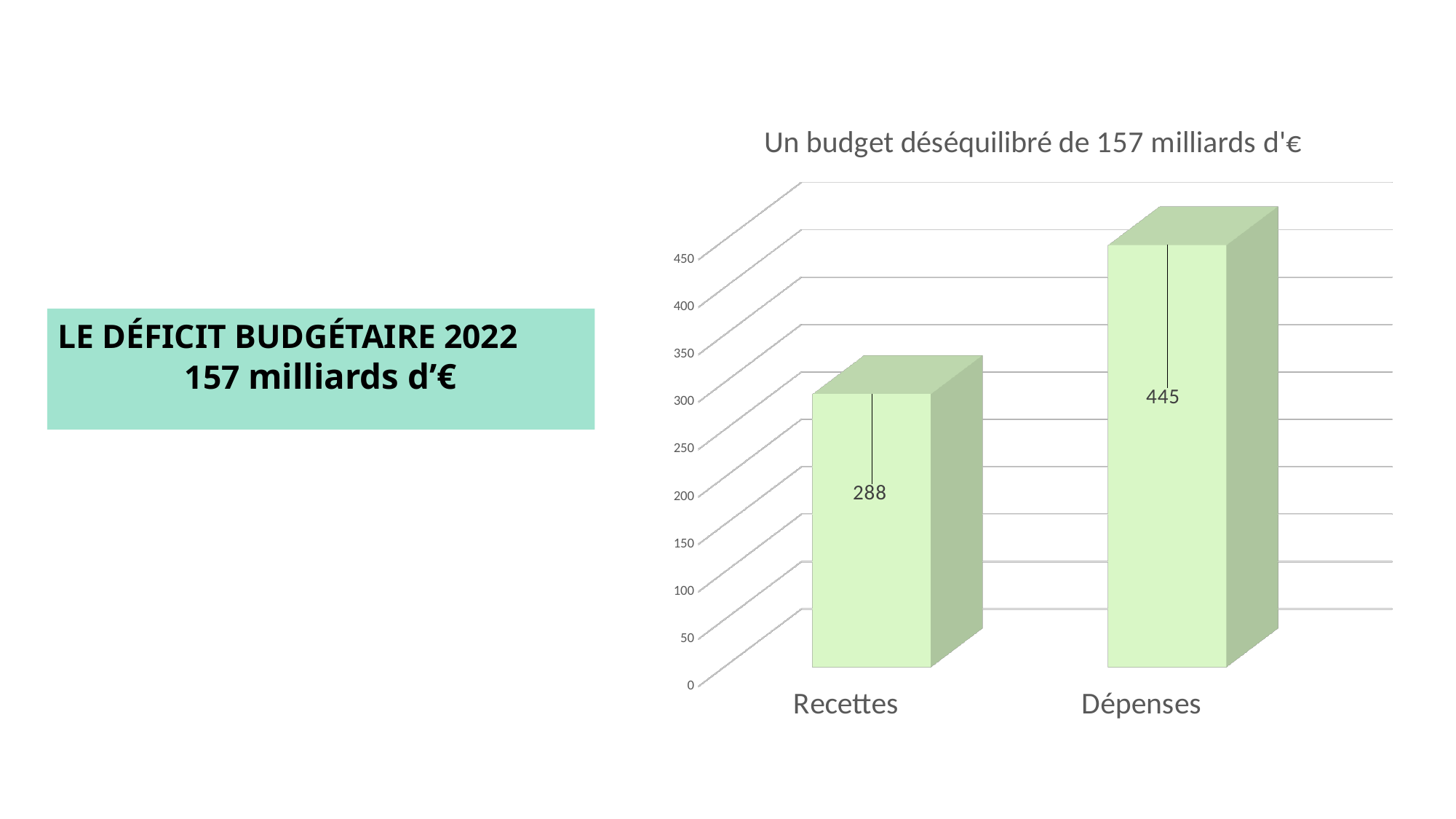
What is the title of the chart? Un budget déséquilibré de 157 milliards d'€ Which category has the highest value? Dépenses Is the value for Dépenses greater or less than 400? greater What is the value for Recettes? 288 How many categories are shown on the chart? 2 What kind of chart is shown on the slide? bar chart Which is larger, the value for Recettes or the value for Dépenses? Dépenses Is the value for Recettes greater or less than 300? less Which category has the lowest value? Recettes What is the difference between the values for Dépenses and Recettes? 157 What is the highest value labelled on the vertical axis? 450 What is the value for Dépenses? 445